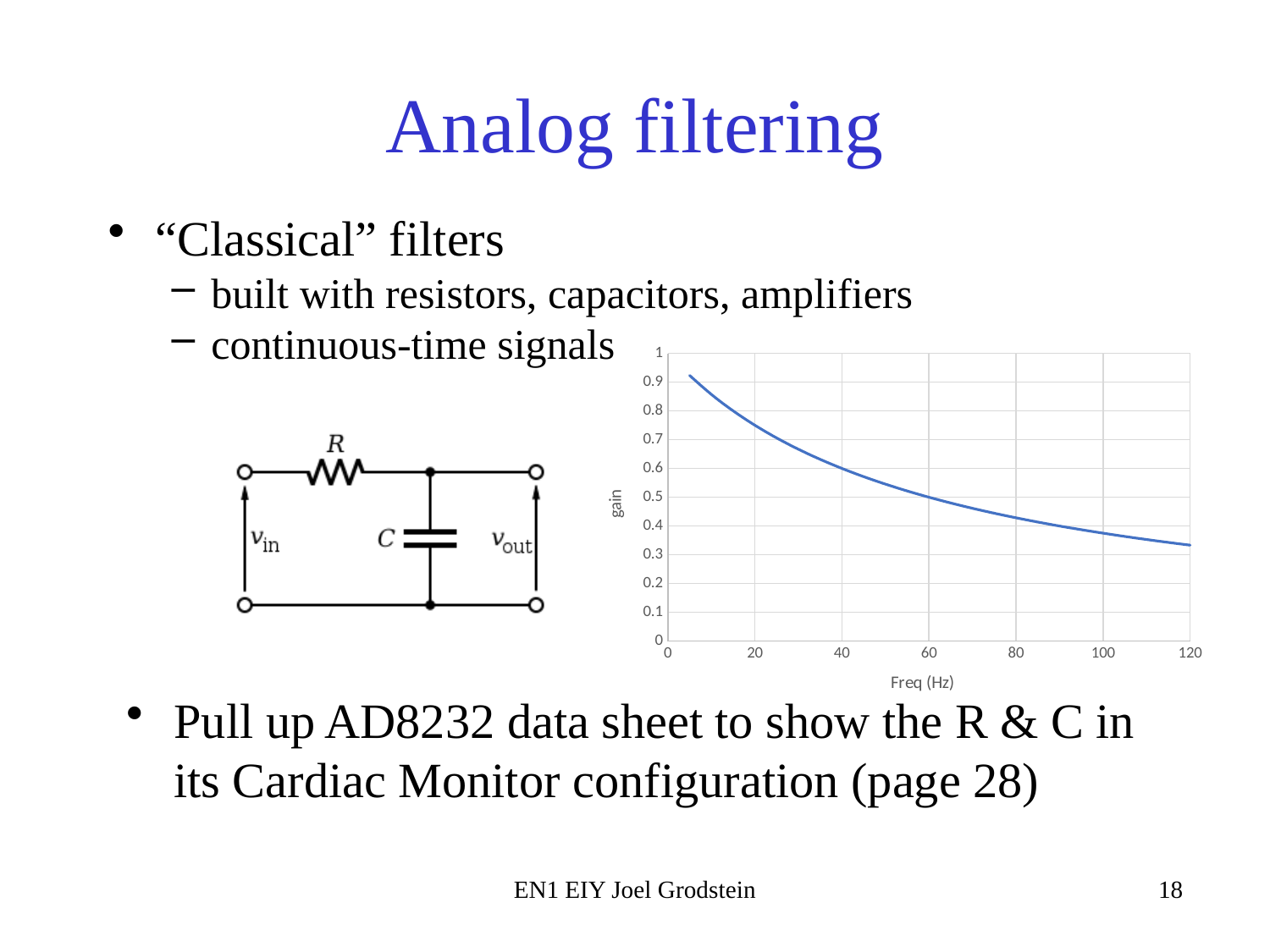
Is the gain at 120 Hz greater or less than 0.4? less Is the gain at 100 Hz greater or less than 0.3? greater Is the gain at 80 Hz greater or less than 0.6? less What kind of chart is shown on the slide? line chart What is the label of the x axis of the chart? Freq (Hz) Which frequency has the higher gain, 20 Hz or 100 Hz? 20 Hz What is the maximum value shown on the y axis of the chart? 1 What is the label of the y axis of the chart? gain Does the gain rise or fall as frequency increases along the x axis? fall How many lines are plotted on the chart? 1